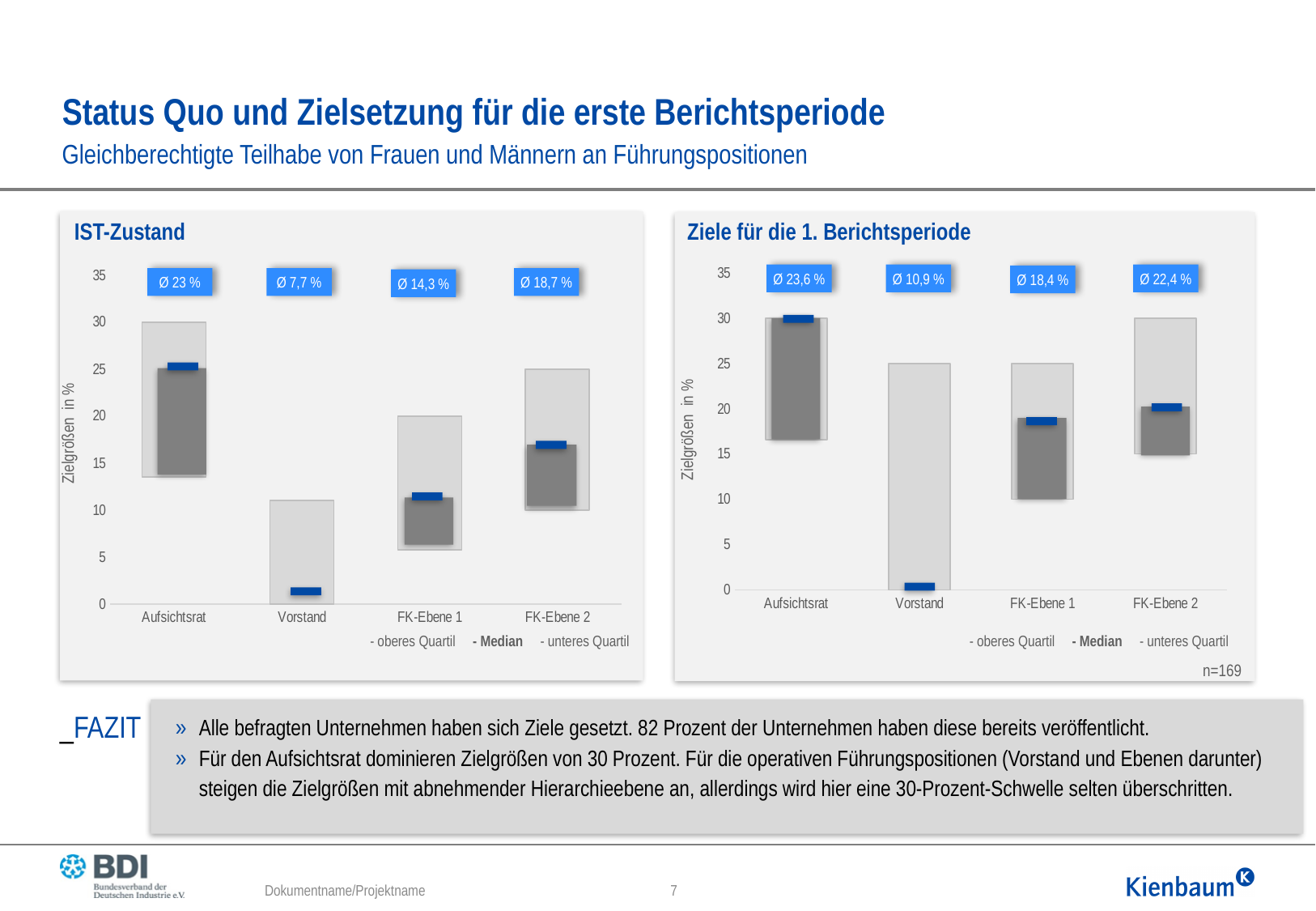
In the Ziele für die 1. Berichtsperiode chart, is the median for Aufsichtsrat greater or less than 25? greater In the IST-Zustand chart, is the median for Vorstand greater or less than 5? less In the Ziele für die 1. Berichtsperiode chart, what is the difference between the average values for Aufsichtsrat and Vorstand? 12,7 % In the IST-Zustand chart, which category has the lowest average (Ø) value? Vorstand In the Ziele für die 1. Berichtsperiode chart, what is the average (Ø) value shown for FK-Ebene 2? Ø 22,4 % In the IST-Zustand chart, what is the average (Ø) value shown for Vorstand? Ø 7,7 % In the Ziele für die 1. Berichtsperiode chart, what is the average (Ø) value shown for FK-Ebene 1? Ø 18,4 % In the IST-Zustand chart, is the average value for FK-Ebene 1 or FK-Ebene 2 larger? FK-Ebene 2 What sample size (n) is stated below the Ziele für die 1. Berichtsperiode chart? n=169 In the Ziele für die 1. Berichtsperiode chart, which category has the highest average (Ø) value? Aufsichtsrat In the IST-Zustand chart, what is the average (Ø) value shown for Aufsichtsrat? Ø 23 % How many categories are shown on the x axis of the IST-Zustand chart? 4